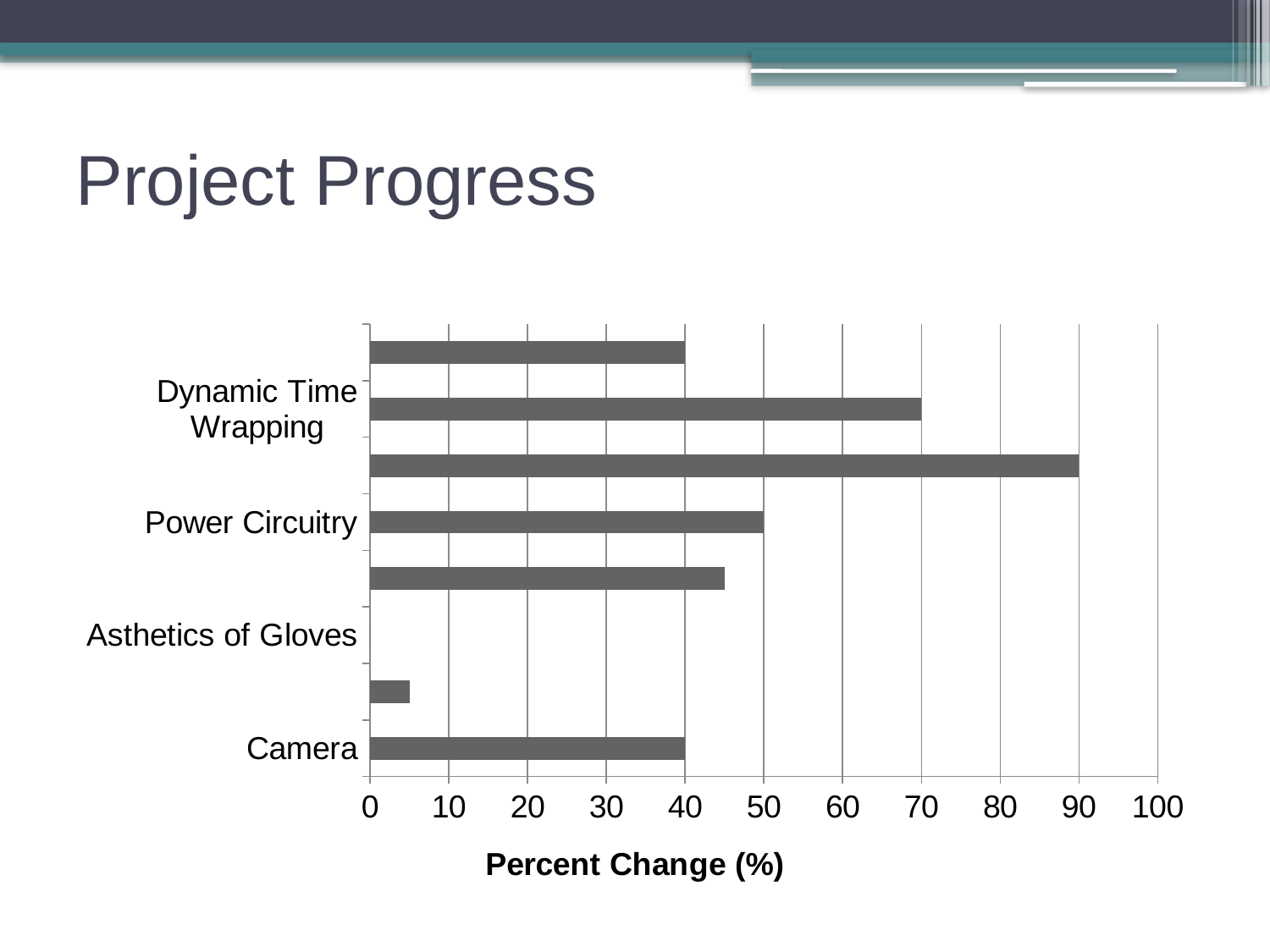
What is the value for Camera? 40 What is the value for Power Circuitry? 50 What is the difference between the value for Dynamic Time Wrapping and the value for Camera? 30 Is the value for Asthetics of Gloves greater or less than 10? less Among Camera, Power Circuitry and Dynamic Time Wrapping, which has the highest value? Dynamic Time Wrapping How many category labels are shown on the vertical axis? 4 Which is larger, the value for Dynamic Time Wrapping or the value for Power Circuitry? Dynamic Time Wrapping What is the value for Dynamic Time Wrapping? 70 Which is larger, the value for Power Circuitry or the value for Camera? Power Circuitry Is the value for Dynamic Time Wrapping greater or less than 60? greater What is the title of the horizontal axis? Percent Change (%) What kind of chart is shown on the slide? bar chart